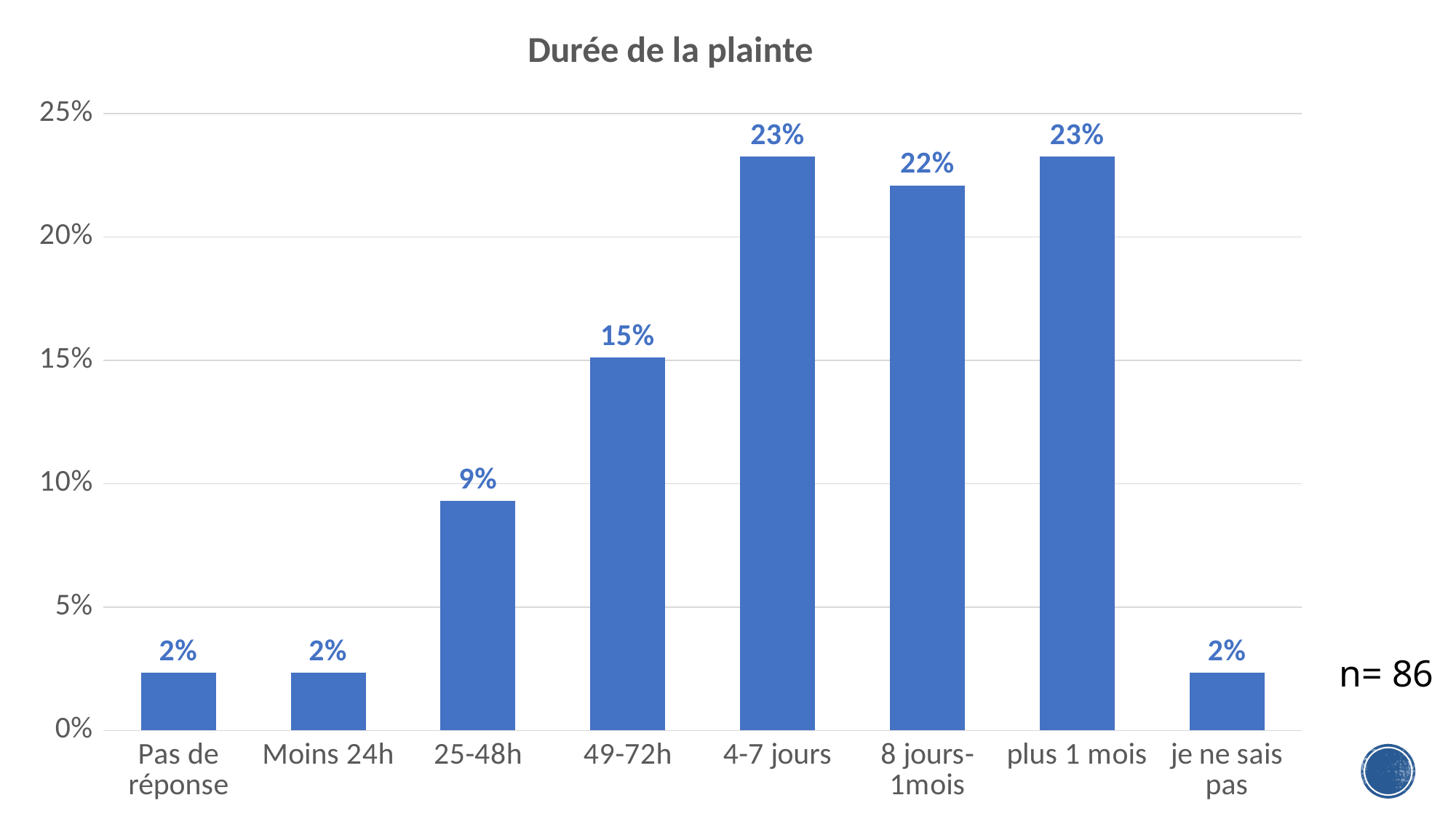
What is the highest value shown on the chart? 23% What is the difference between the values for 4-7 jours and 49-72h? 8% What is the value for Moins 24h? 2% Which is larger, the value for 25-48h or the value for 49-72h? 49-72h Is the value for 8 jours-1mois greater or less than 20%? greater How many categories are shown on the x axis? 8 What is the value for 49-72h? 15% What kind of chart is shown on the slide? bar chart What is the title of the chart? Durée de la plainte What is the value for 8 jours-1mois? 22% What is the value for 25-48h? 9% What is the lowest value shown on the chart? 2%